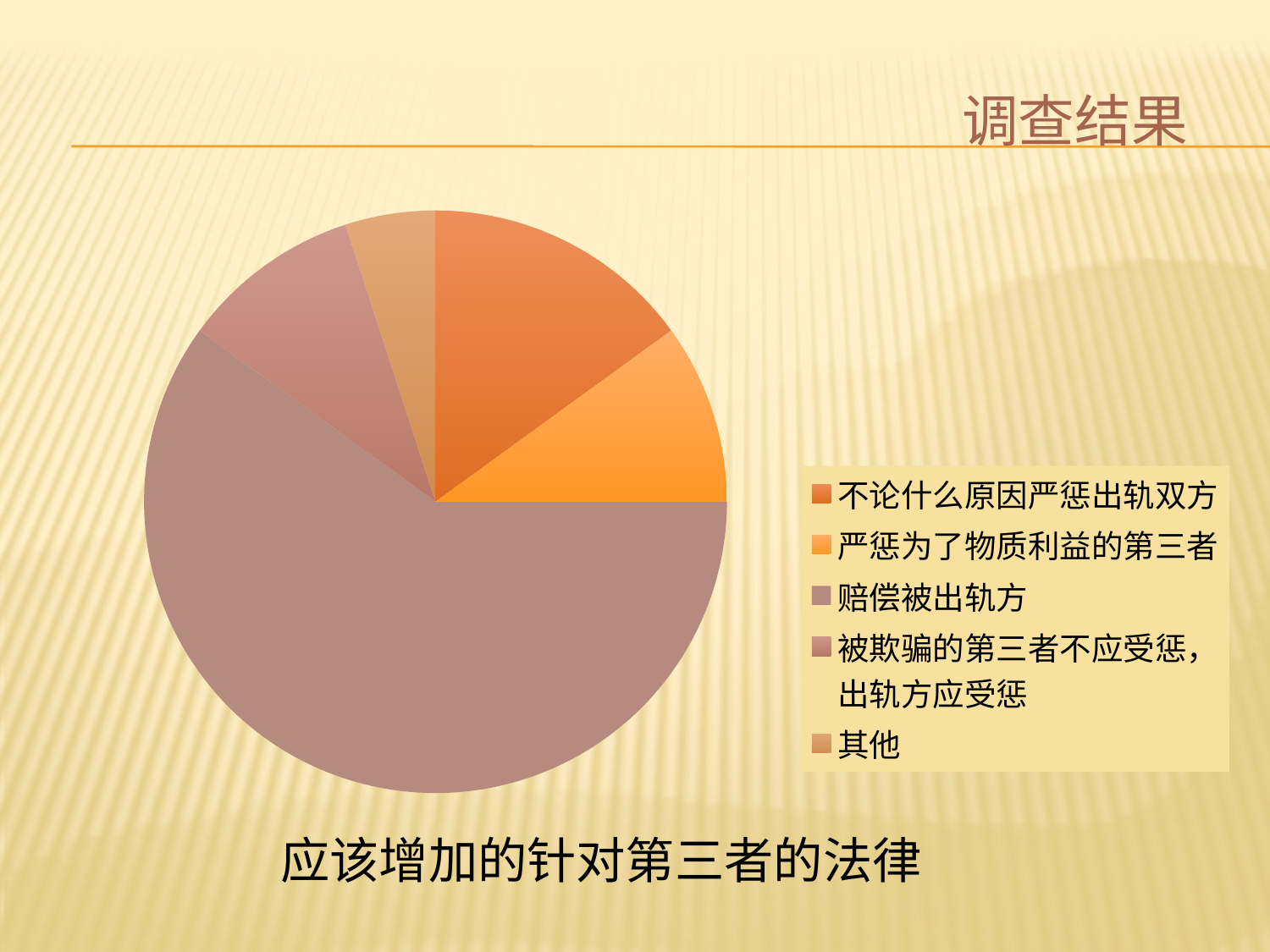
Which category has the smallest slice of the pie chart? 其他 What is the title of the pie chart? 应该增加的针对第三者的法律 Which category has the largest slice of the pie chart? 赔偿被出轨方 Which slice is larger: 赔偿被出轨方 or 不论什么原因严惩出轨双方? 赔偿被出轨方 Does the largest slice of the pie chart take up more or less than half of the pie? more Which legend entry is shown in the first (top) position of the legend? 不论什么原因严惩出轨双方 How many slices does the pie chart have? 5 Which slice is larger: 不论什么原因严惩出轨双方 or 其他? 不论什么原因严惩出轨双方 Which slice is larger: 被欺骗的第三者不应受惩，出轨方应受惩 or 其他? 被欺骗的第三者不应受惩，出轨方应受惩 How many entries does the legend of the pie chart list? 5 What kind of chart is shown on the slide? pie chart